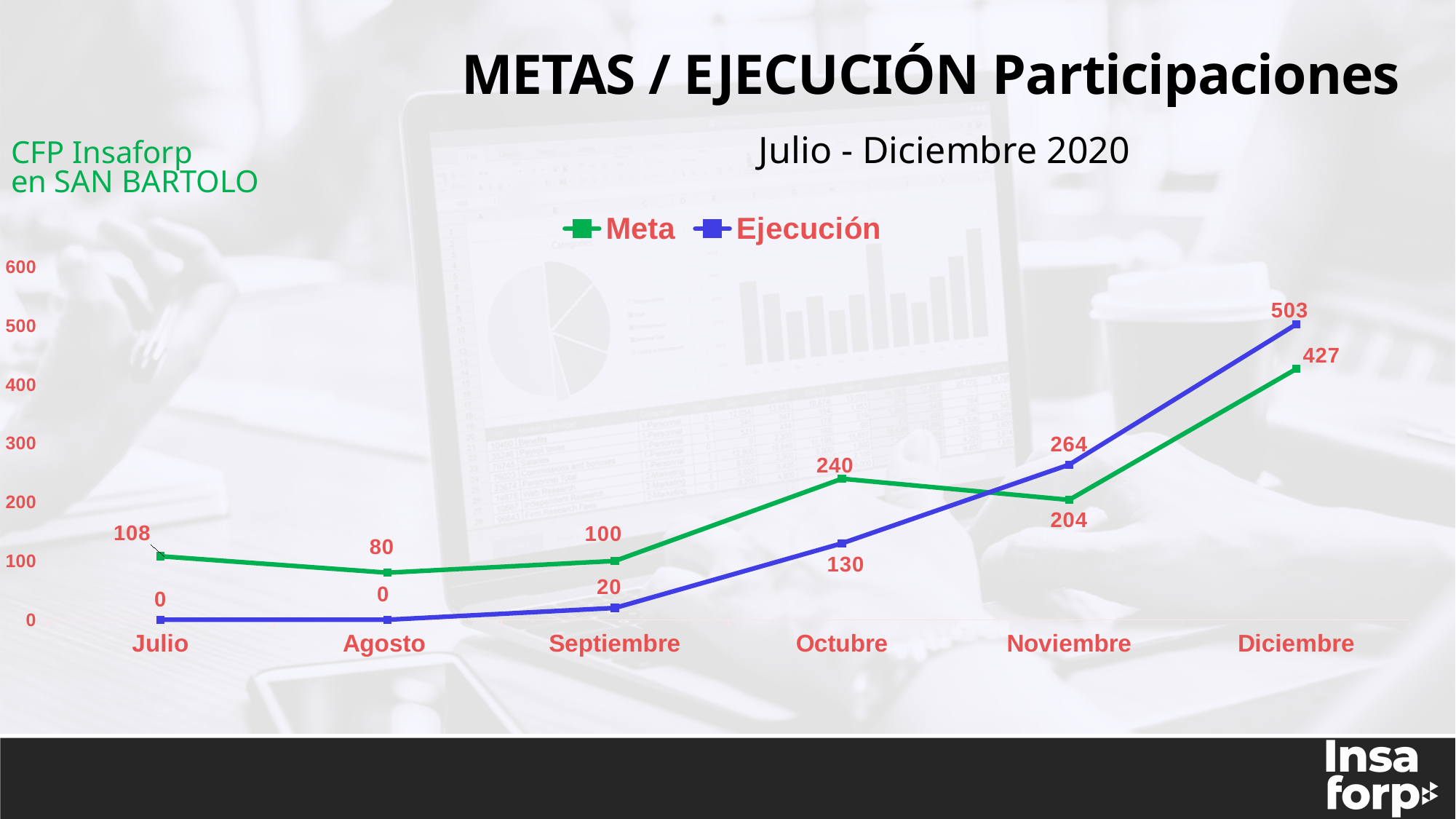
How many months are shown on the x axis? 6 What is the Ejecución value for Septiembre? 20 Which is larger in Noviembre, Meta or Ejecución? Ejecución How many series does the legend list? 2 What colour is the Meta line? Green Does the Ejecución series rise or fall from Septiembre to Diciembre? Rise In which month is the Ejecución value highest? Diciembre What kind of chart is shown on the slide? Line chart In which month is the Meta value lowest? Agosto What is the difference between the Ejecución and Meta values in Diciembre? 76 What is the Meta value for Octubre? 240 What is the Ejecución value for Noviembre? 264